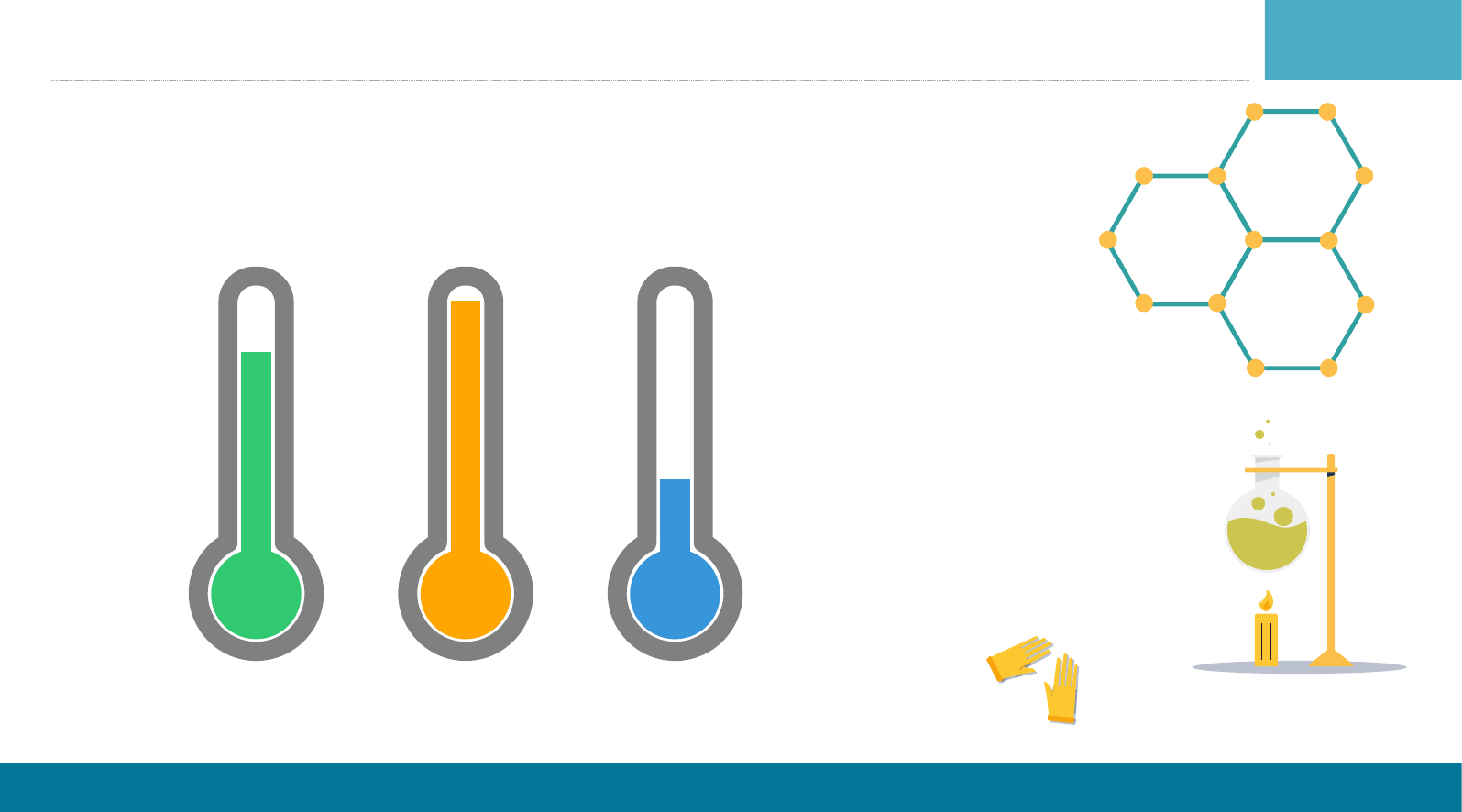
Is the orange thermometer filled higher or lower than the green thermometer? higher What colours are the three thermometer fills, from left to right? green, orange, blue Which thermometer is filled the highest? the orange one Which thermometer is filled the lowest? the blue one Is the green thermometer filled higher or lower than the blue thermometer? higher How many thermometer graphics are shown on the slide? 3